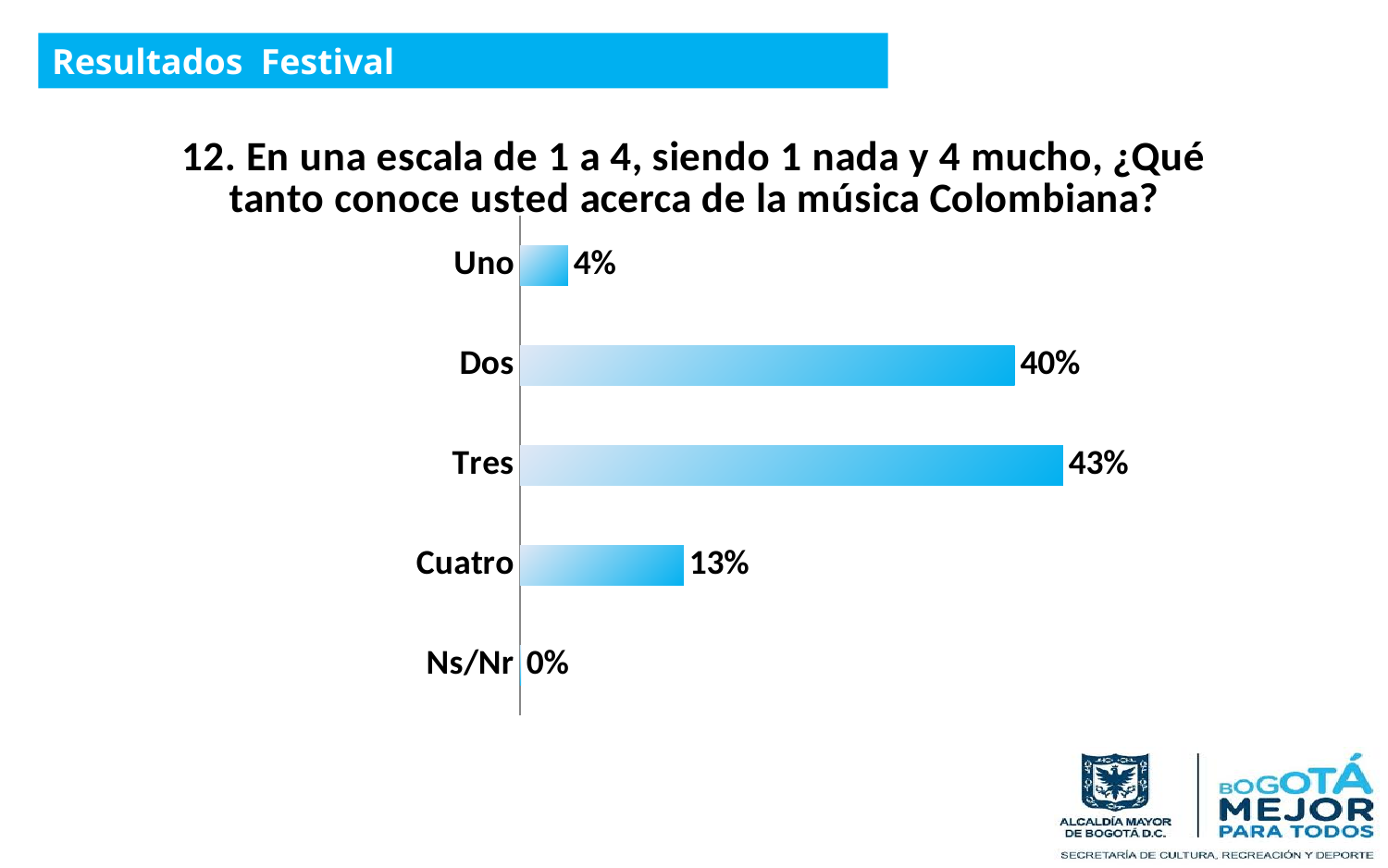
What is the difference between the values for Tres and Dos? 3% What is the value for Dos? 40% What is the difference between the values for Cuatro and Uno? 9% Which category has the highest value? Tres What kind of chart is shown on the slide? Bar chart What is the value for Cuatro? 13% Which category has the lowest value? Ns/Nr How many categories are shown in the chart? 5 What is the title of the chart? 12. En una escala de 1 a 4, siendo 1 nada y 4 mucho, ¿Qué tanto conoce usted acerca de la música Colombiana? Which is larger, the value for Dos or the value for Cuatro? Dos What is the value for Uno? 4% What is the value for Ns/Nr? 0%